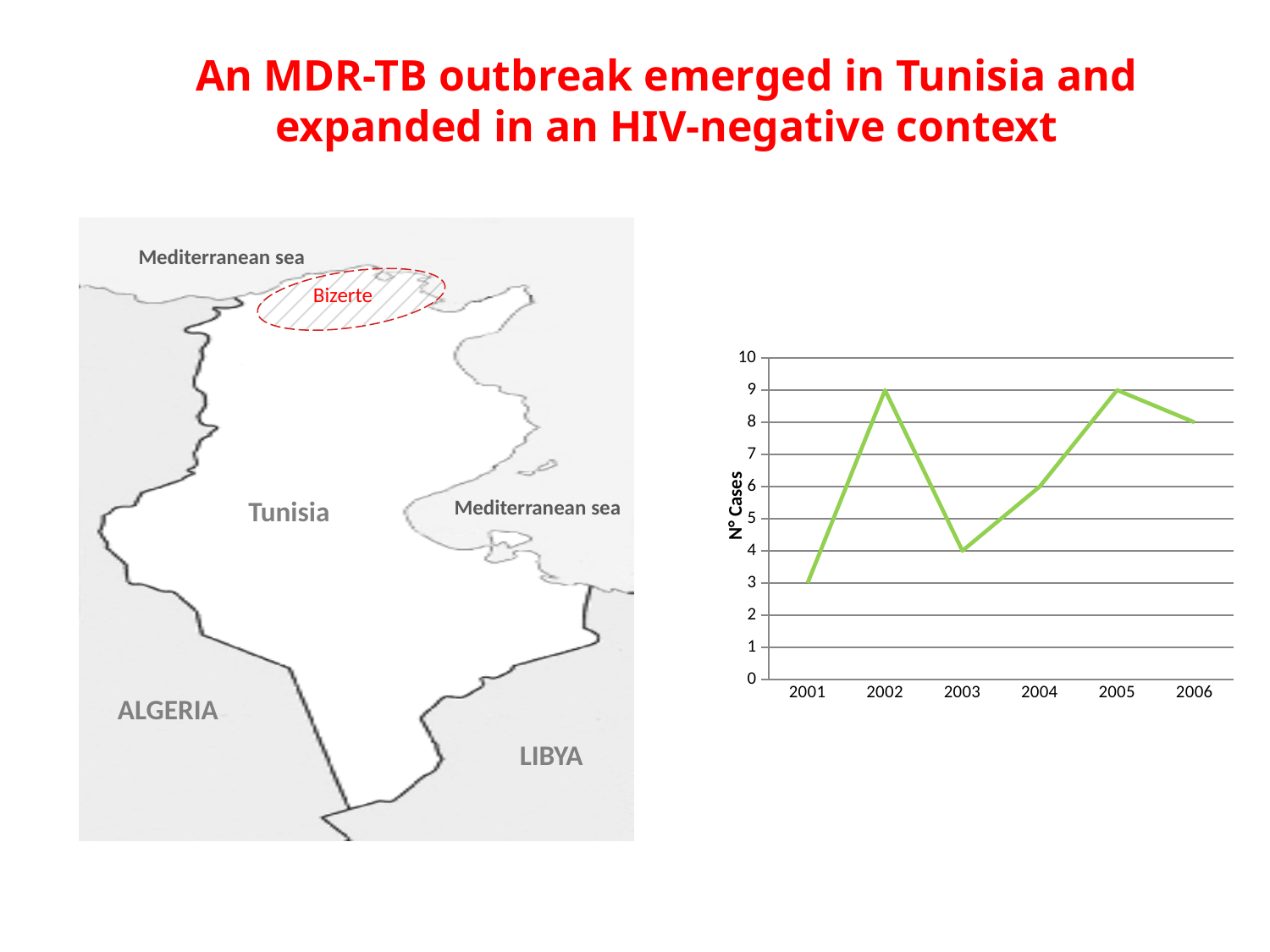
How many years are plotted on the x axis? 6 What is the label of the y axis? N° Cases Do the number of cases rise or fall from 2003 to 2005? rise What is the number of cases in 2001? 3 What is the difference in the number of cases between 2002 and 2003? 5 Which year has more cases, 2004 or 2006? 2006 What kind of chart is shown on the slide? line chart What is the number of cases in 2003? 4 Which year has the lowest number of cases? 2001 What is the number of cases in 2004? 6 Is the number of cases in 2005 greater or less than 5? greater What is the number of cases in 2006? 8